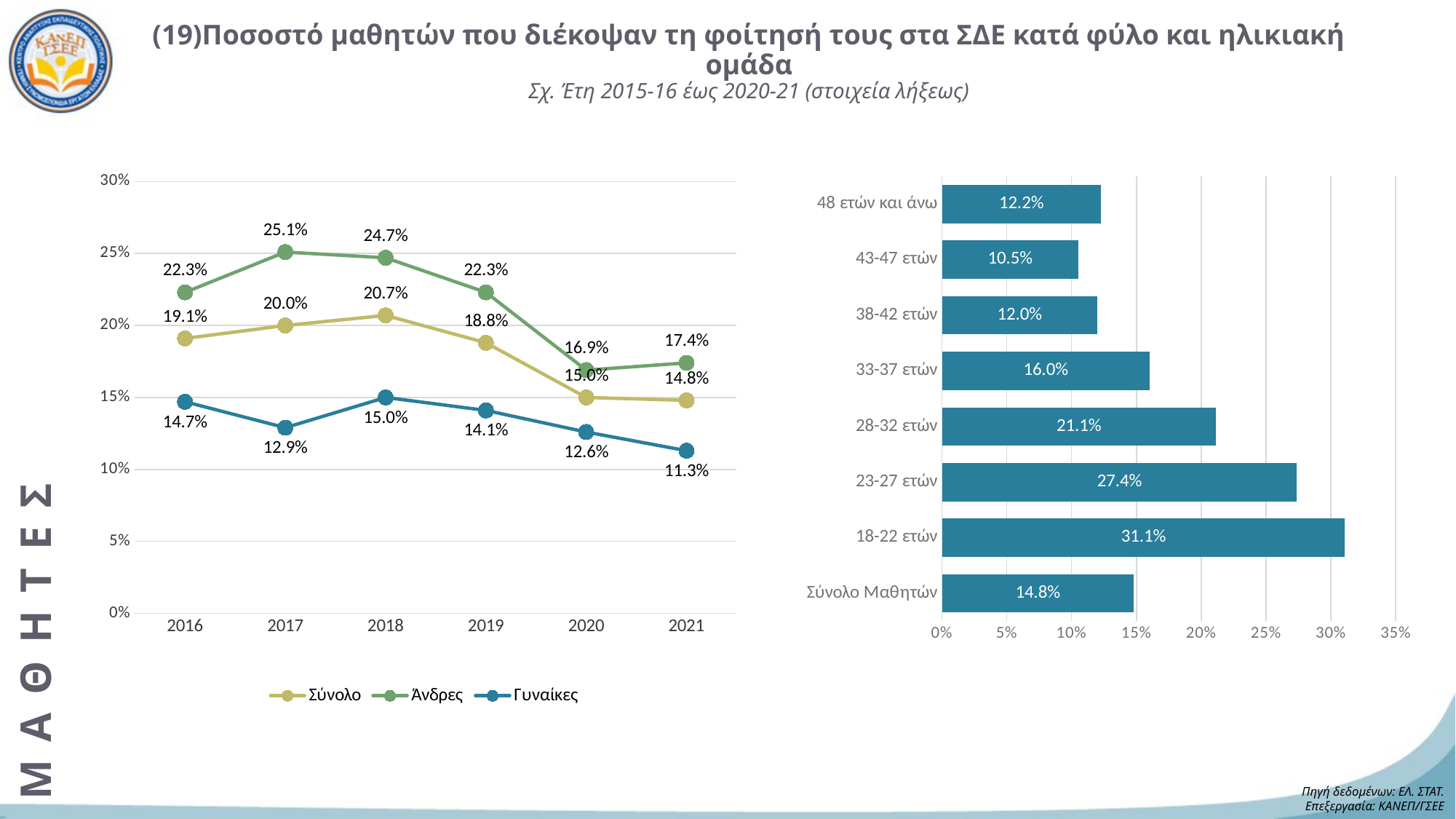
In the bar chart on the right, which category has the lowest value? 43-47 ετών In the line chart on the left, in which year does the Σύνολο series reach its highest value? 2018 In the line chart on the left, does the Σύνολο series rise or fall from 2018 to 2021? fall In the bar chart on the right, which is larger: the value for 33-37 ετών or the value for 38-42 ετών? 33-37 ετών In the line chart on the left, what is the value for Γυναίκες in 2021? 11.3% What type of chart is shown on the right side of the slide? bar chart In the bar chart on the right, what is the value for 23-27 ετών? 27.4% In the bar chart on the right, which age group has the highest value? 18-22 ετών In the line chart on the left, in which year is the Γυναίκες series lowest? 2021 In the line chart on the left, how many series does the legend list? 3 In the line chart on the left, what is the value for Άνδρες in 2017? 25.1% In the line chart on the left, what is the difference between Άνδρες and Γυναίκες in 2016? 7.6%